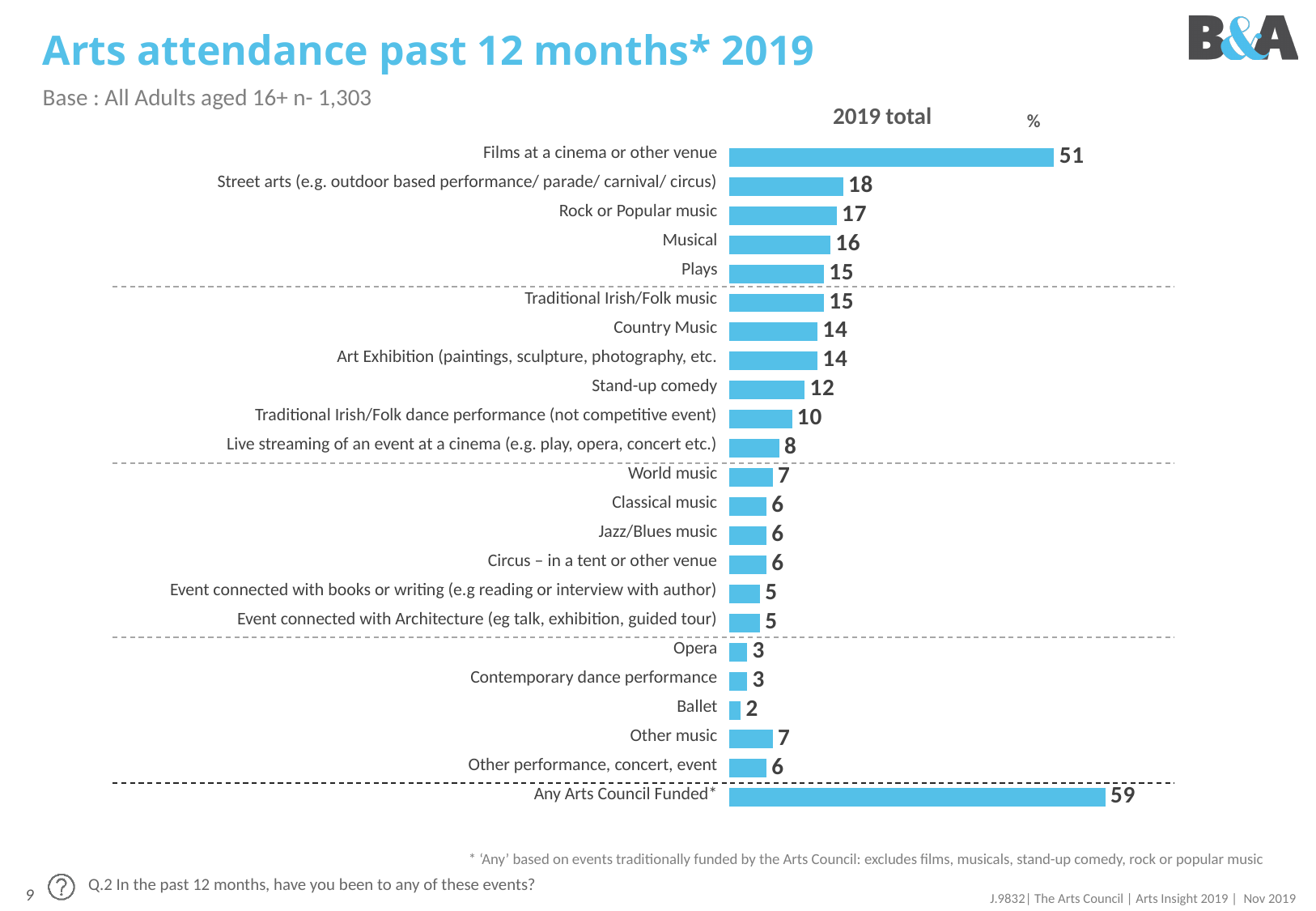
What is the value for Films at a cinema or other venue? 51 Which is larger, the value for Musical or the value for Country Music? Musical Which is larger, the value for Live streaming of an event at a cinema or the value for Traditional Irish/Folk dance performance? Traditional Irish/Folk dance performance What is the value for Stand-up comedy? 12 What kind of chart is shown on the slide? Bar chart Which category has the lowest value? Ballet What is the value for Any Arts Council Funded*? 59 Which category has the highest value? Any Arts Council Funded* What is the difference between the values for Rock or Popular music and Opera? 14 What is the difference between the values for Films at a cinema or other venue and Street arts? 33 What is the title of the chart? Arts attendance past 12 months* 2019 How many categories are plotted in the chart? 23